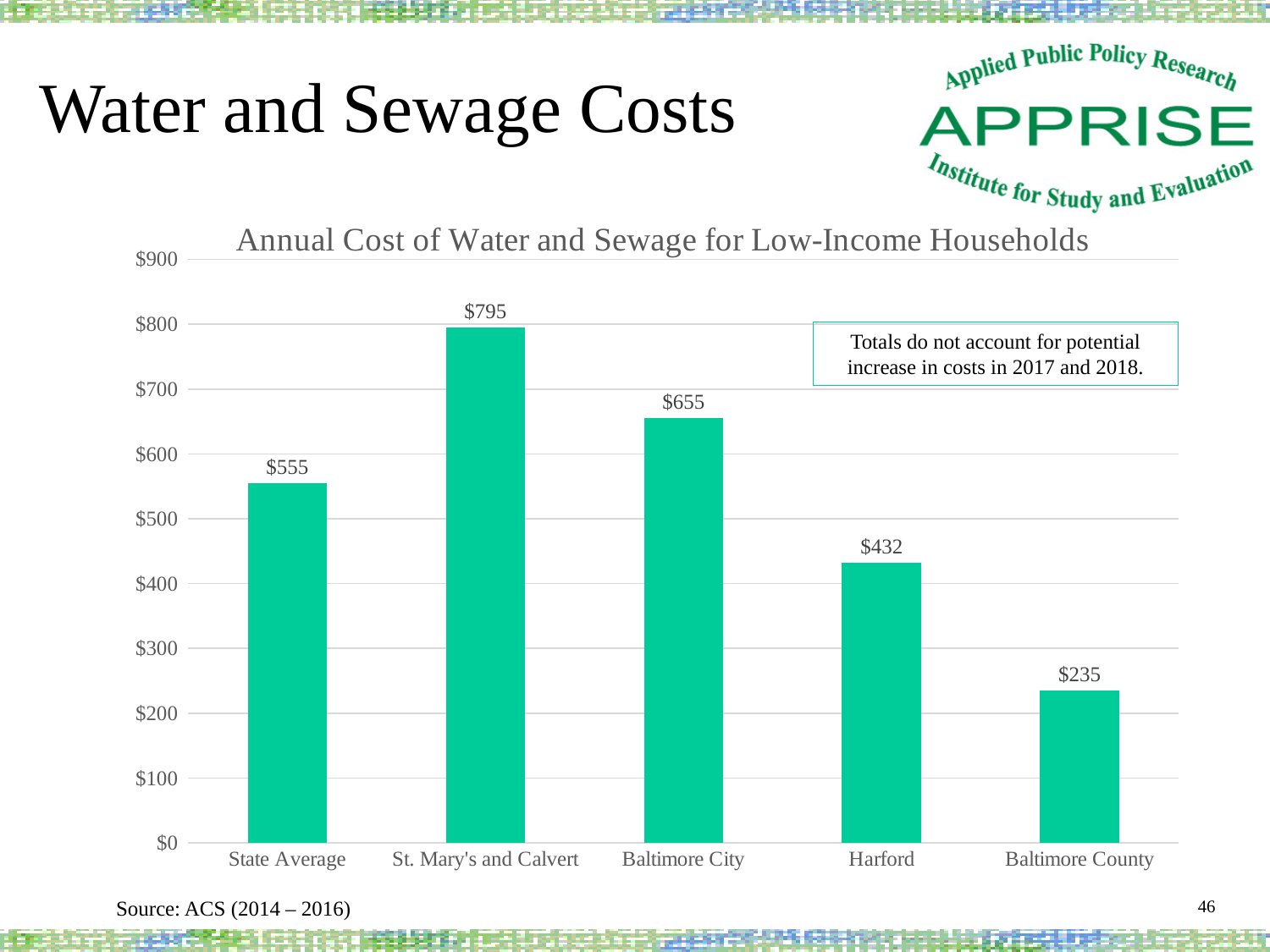
What is the value shown for the State Average? $555 How much higher is the cost for Baltimore City than the State Average? $100 What is the title of the chart? Annual Cost of Water and Sewage for Low-Income Households What is the annual cost of water and sewage for low-income households in Baltimore City? $655 Which is larger, the annual cost for Harford or for Baltimore County? Harford What is the annual cost shown for Harford? $432 Which category has the highest annual cost of water and sewage? St. Mary's and Calvert How many categories are shown on the x axis of the chart? 5 What kind of chart is shown on the slide? Bar chart Is the value for Harford greater or less than $500? less What is the difference between the annual cost for St. Mary's and Calvert and the annual cost for Baltimore County? $560 Which category has the lowest annual cost of water and sewage? Baltimore County